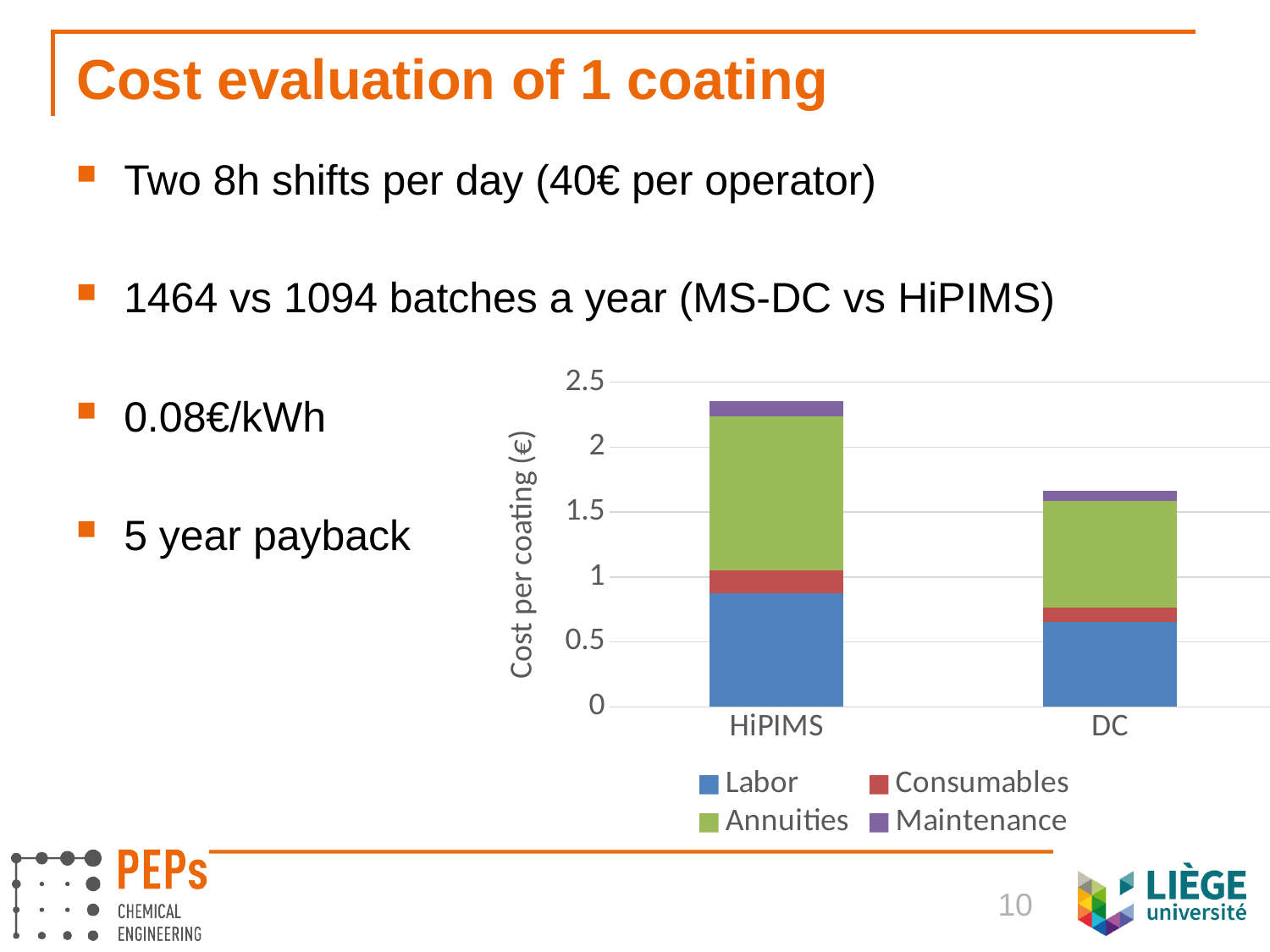
Which category has the tallest stacked bar in the chart? HiPIMS Is the total cost per coating for DC greater or less than 2? less Which series is shown in blue in the chart's legend? Labor Which category has the higher total cost per coating, HiPIMS or DC? HiPIMS How many categories are shown on the x axis of the chart? 2 Is the total cost per coating for HiPIMS greater or less than 2? greater Which category has the larger Annuities segment, HiPIMS or DC? HiPIMS Is the total cost per coating for DC greater or less than 1.5? greater How many series does the chart's legend list? 4 What is the title of the chart's vertical axis? Cost per coating (€) What kind of chart is shown on the slide? Stacked bar chart